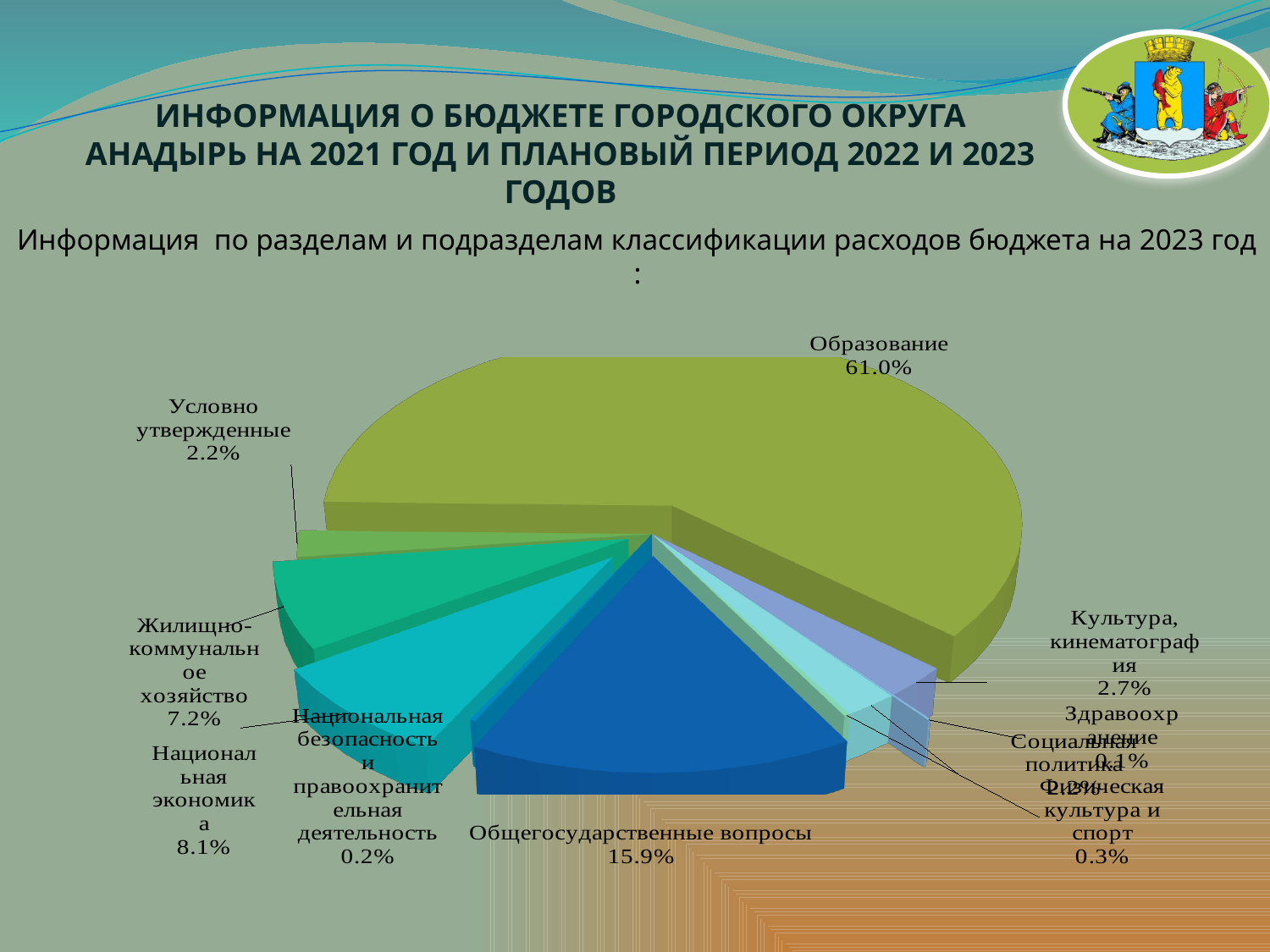
What is the share for Национальная экономика? 8.1% Which is larger: the share for Национальная экономика or for Жилищно-коммунальное хозяйство? Национальная экономика Which section has the smallest share in the pie chart? Здравоохранение By how many percentage points does Образование exceed Общегосударственные вопросы? 45.1 percentage points What percentage is shown for Общегосударственные вопросы? 15.9% How many sections (slices) are shown in the pie chart? 10 What type of chart is used on the slide? Pie chart What share is shown for Культура, кинематография? 2.7% What share of the 2023 budget expenditure does Образование (Education) account for? 61.0% What percentage is labelled for Жилищно-коммунальное хозяйство? 7.2% Which section has the largest share of the 2023 budget expenditure? Образование What percentage is given for Условно утвержденные? 2.2%